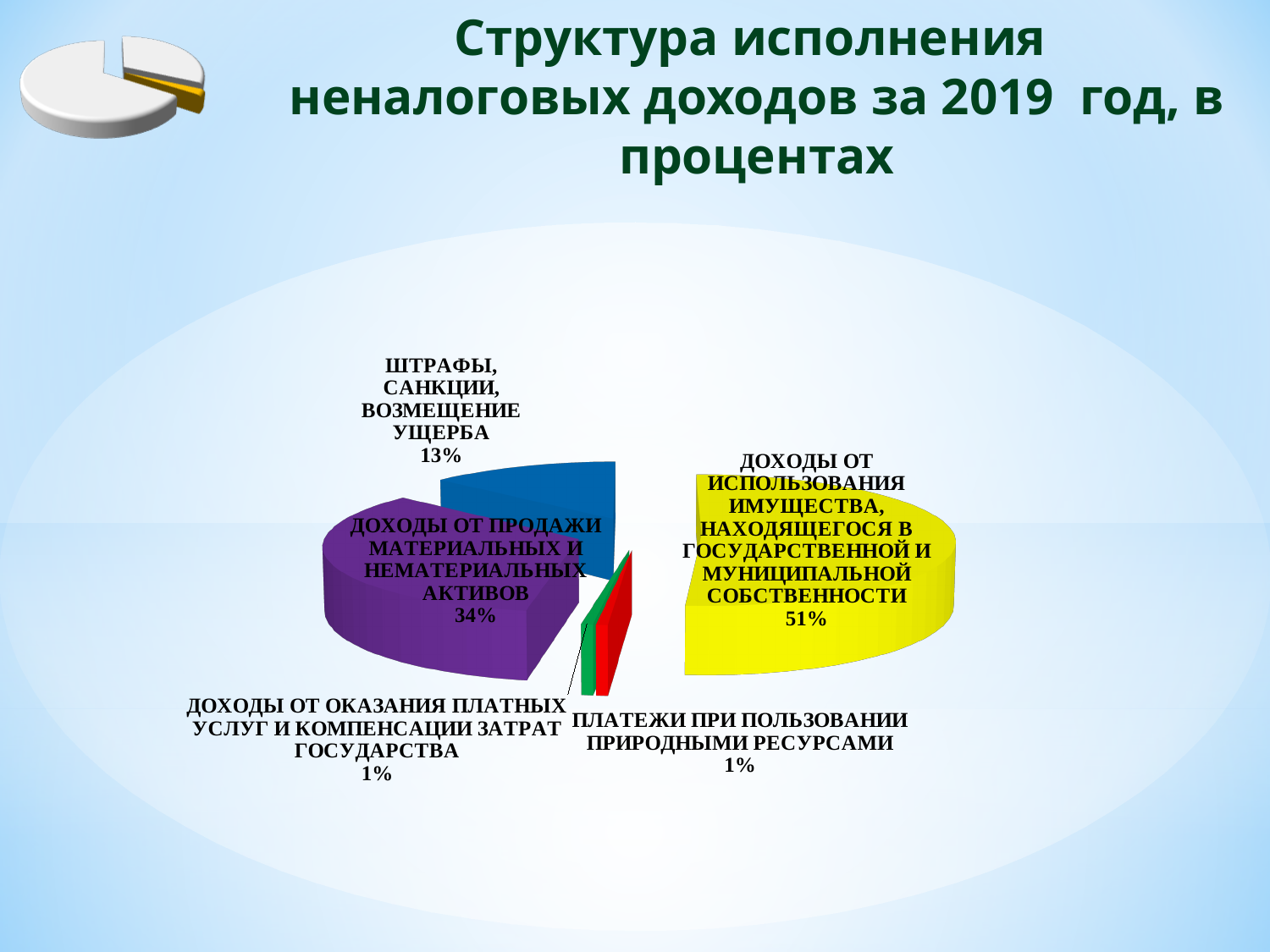
What percentage is shown for "ДОХОДЫ ОТ ПРОДАЖИ МАТЕРИАЛЬНЫХ И НЕМАТЕРИАЛЬНЫХ АКТИВОВ"? 34% What percentage is shown for "ПЛАТЕЖИ ПРИ ПОЛЬЗОВАНИИ ПРИРОДНЫМИ РЕСУРСАМИ"? 1% What colour is the slice for "ДОХОДЫ ОТ ИСПОЛЬЗОВАНИЯ ИМУЩЕСТВА, НАХОДЯЩЕГОСЯ В ГОСУДАРСТВЕННОЙ И МУНИЦИПАЛЬНОЙ СОБСТВЕННОСТИ"? yellow What year does the chart title say the data is for? 2019 What is the difference in percentage points between "ДОХОДЫ ОТ ПРОДАЖИ МАТЕРИАЛЬНЫХ И НЕМАТЕРИАЛЬНЫХ АКТИВОВ" and "ШТРАФЫ, САНКЦИИ, ВОЗМЕЩЕНИЕ УЩЕРБА"? 21% Which category has the largest share of the pie? ДОХОДЫ ОТ ИСПОЛЬЗОВАНИЯ ИМУЩЕСТВА, НАХОДЯЩЕГОСЯ В ГОСУДАРСТВЕННОЙ И МУНИЦИПАЛЬНОЙ СОБСТВЕННОСТИ What is the difference in percentage points between "ДОХОДЫ ОТ ИСПОЛЬЗОВАНИЯ ИМУЩЕСТВА..." (51%) and "ДОХОДЫ ОТ ПРОДАЖИ МАТЕРИАЛЬНЫХ И НЕМАТЕРИАЛЬНЫХ АКТИВОВ" (34%)? 17% How many slices does the pie chart have? 5 What share of the pie is labelled "ДОХОДЫ ОТ ИСПОЛЬЗОВАНИЯ ИМУЩЕСТВА, НАХОДЯЩЕГОСЯ В ГОСУДАРСТВЕННОЙ И МУНИЦИПАЛЬНОЙ СОБСТВЕННОСТИ"? 51% What kind of chart is shown on the slide? pie chart What percentage is shown for "ШТРАФЫ, САНКЦИИ, ВОЗМЕЩЕНИЕ УЩЕРБА"? 13% Which is larger: the share for "ШТРАФЫ, САНКЦИИ, ВОЗМЕЩЕНИЕ УЩЕРБА" or the share for "ДОХОДЫ ОТ ПРОДАЖИ МАТЕРИАЛЬНЫХ И НЕМАТЕРИАЛЬНЫХ АКТИВОВ"? ДОХОДЫ ОТ ПРОДАЖИ МАТЕРИАЛЬНЫХ И НЕМАТЕРИАЛЬНЫХ АКТИВОВ